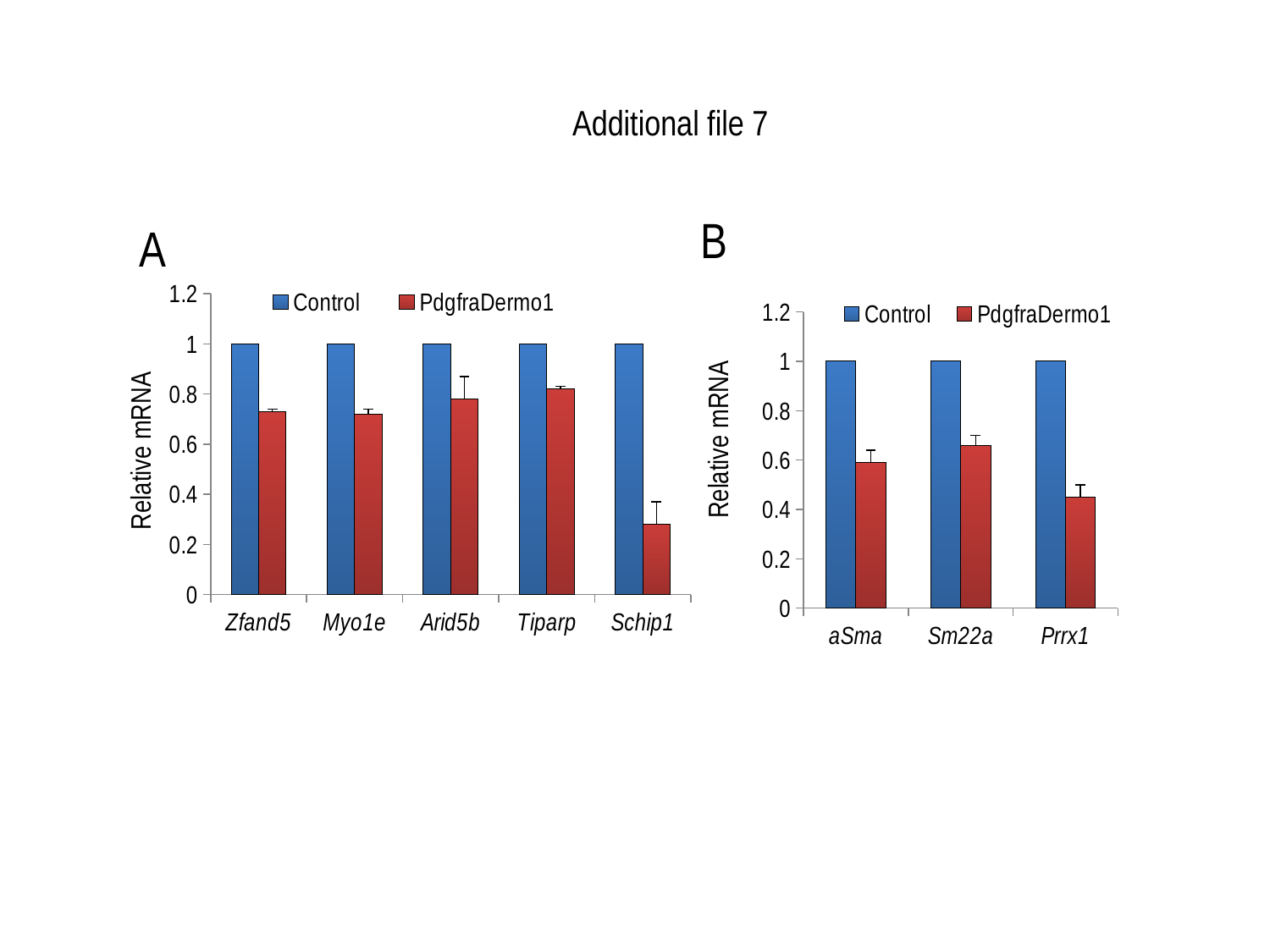
In chart A, what is the Control value for Zfand5? 1 In chart B, which is larger for Sm22a: the Control value or the PdgfraDermo1 value? Control In chart A, is the PdgfraDermo1 value for Schip1 greater or less than 0.4? less In chart B, what is the Control value for Prrx1? 1 In chart B, which category has the lowest PdgfraDermo1 value? Prrx1 How many series does the legend of chart B list? 2 In chart B, is the PdgfraDermo1 value for Prrx1 greater or less than 0.6? less How many categories are shown on the x axis of chart A? 5 What type of chart is chart B? bar chart In chart A, which category has the lowest PdgfraDermo1 value? Schip1 In chart A, which is larger: the PdgfraDermo1 value for Tiparp or for Schip1? Tiparp In chart A, is the PdgfraDermo1 value for Zfand5 greater or less than 0.6? greater